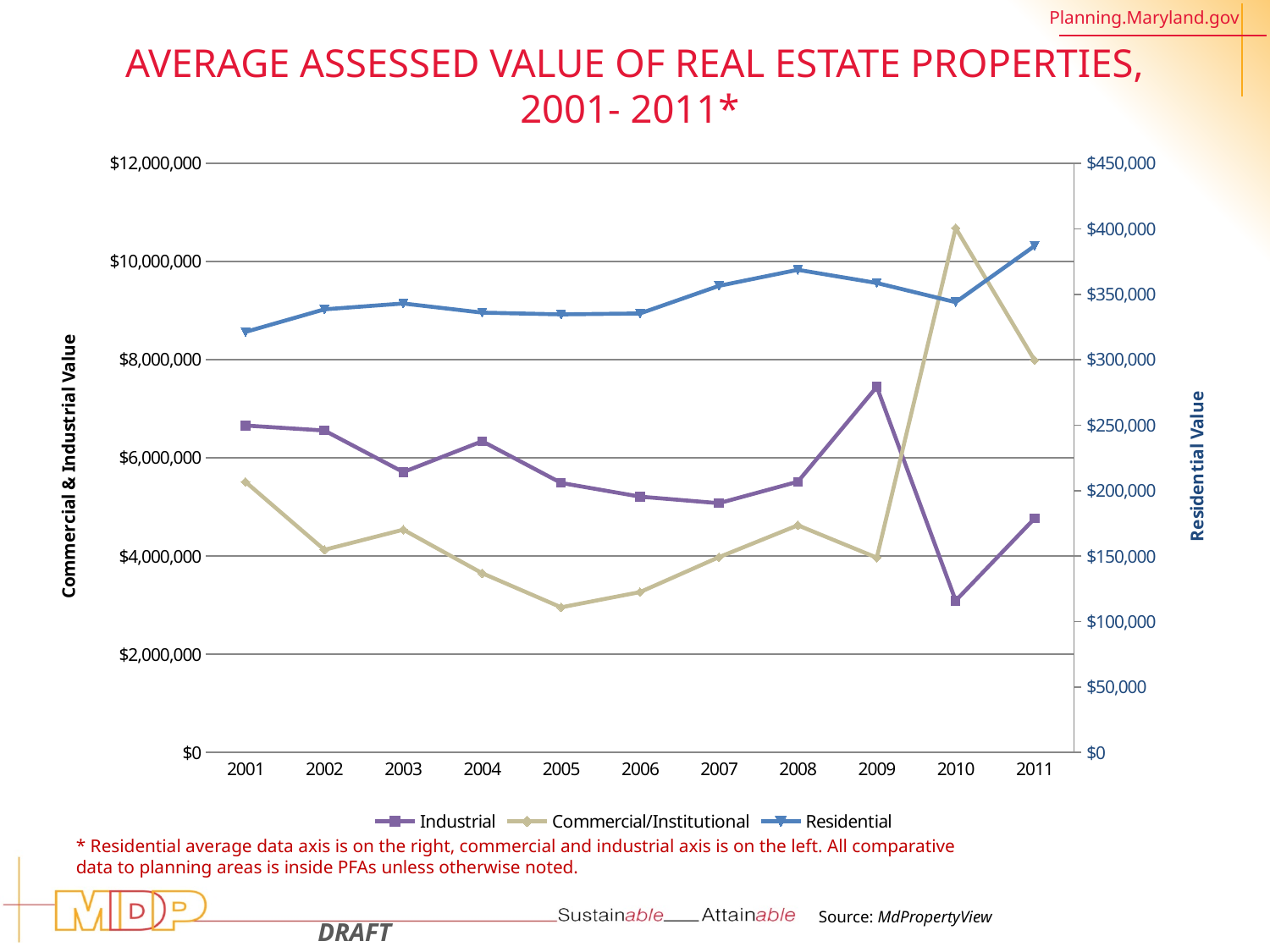
How many years are plotted along the x axis? 11 In which year is the Residential value highest? 2011 In which year does the Industrial series reach its lowest value? 2010 Is the Industrial value for 2009 greater or less than $6,000,000? greater What kind of chart is shown on the slide? Line chart Is the Commercial/Institutional value for 2005 greater or less than $4,000,000? less Is the Residential value for 2011 greater or less than $350,000? greater What is the label of the right-hand vertical axis? Residential Value In 2001, which is larger: the Industrial value or the Commercial/Institutional value? Industrial In which year does the Commercial/Institutional series reach its highest value? 2010 Does the Residential series overall rise or fall from 2001 to 2011? Rise How many series does the legend list? 3